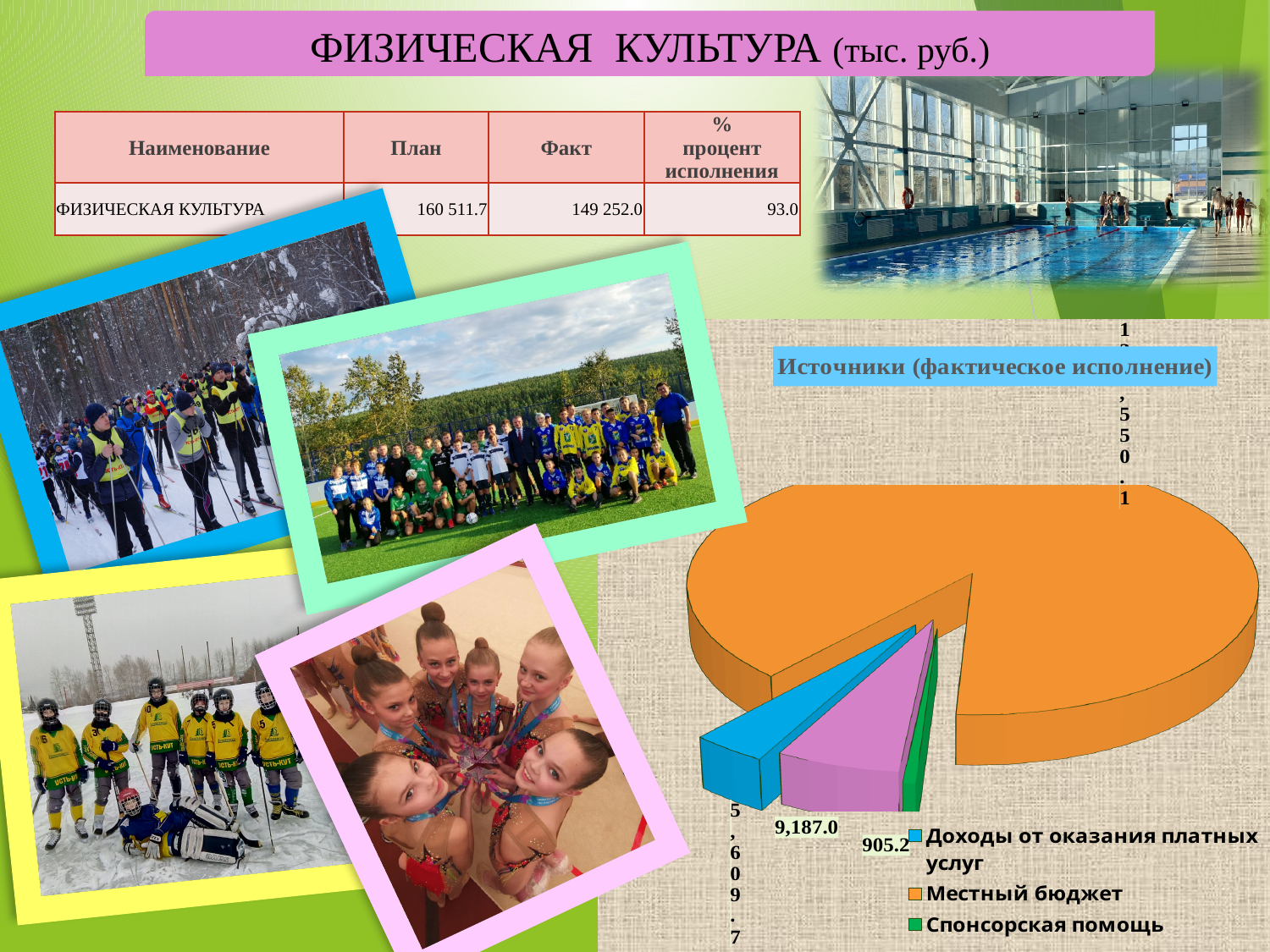
How many entries does the legend of the pie chart list? 3 In the pie chart, what is the value for Доходы от оказания платных услуг? 5,609.7 Which category has the largest slice in the pie chart? Местный бюджет In the pie chart, what is the difference between Доходы от оказания платных услуг and Спонсорская помощь? 4,704.5 Which category has the smallest slice in the pie chart? Спонсорская помощь In the pie chart, what is the value for Спонсорская помощь? 905.2 What is the title of the pie chart? Источники (фактическое исполнение) What kind of chart is shown on the right side of the slide? pie chart In the pie chart, which is larger: Доходы от оказания платных услуг or Спонсорская помощь? Доходы от оказания платных услуг What colour represents Местный бюджет in the pie chart? orange